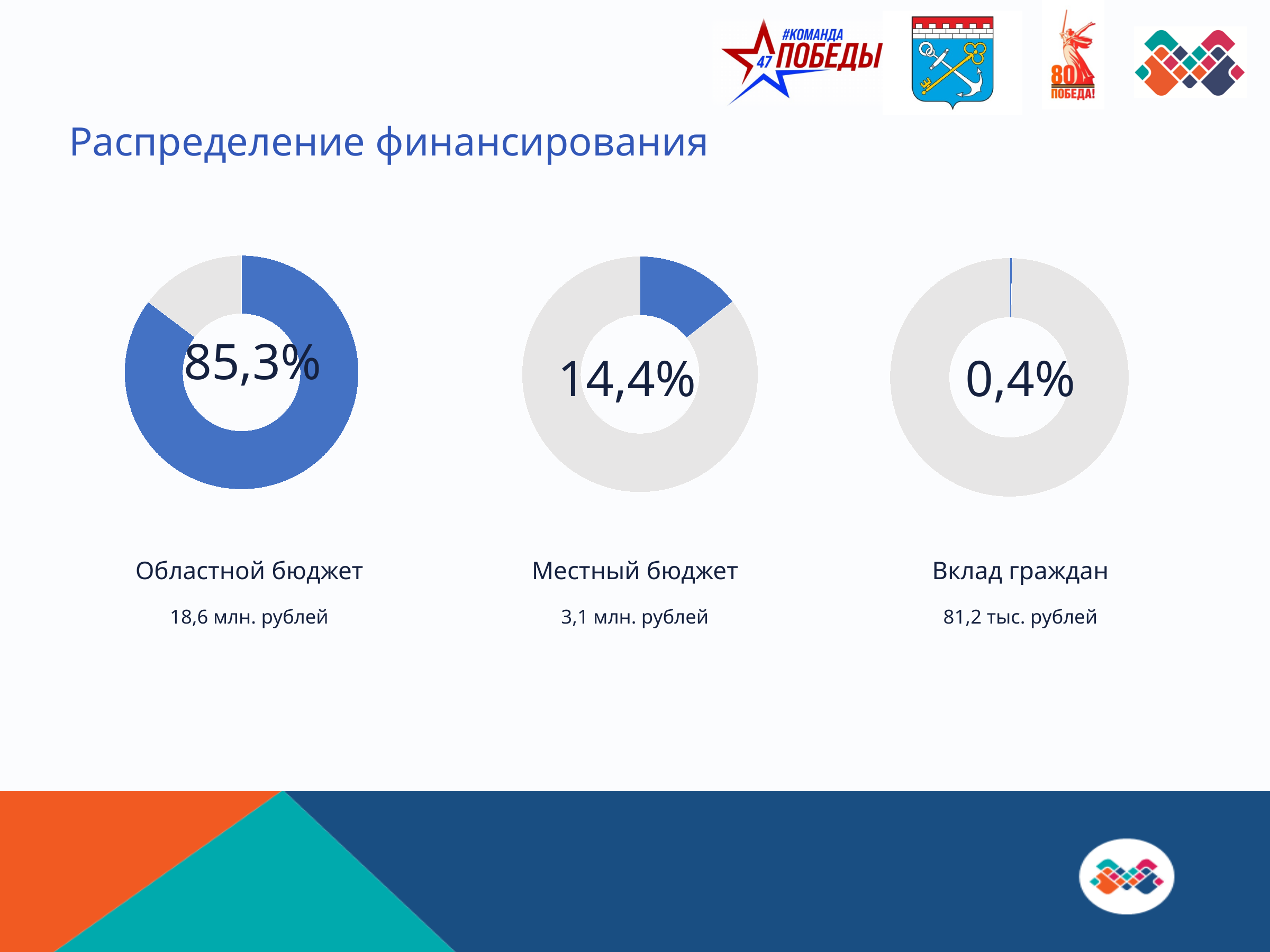
What amount in rubles is given under the Вклад граждан chart? 81,2 тыс. рублей What share is shown in the donut chart for Областной бюджет? 85,3% Which is larger, the share for Местный бюджет or the share for Вклад граждан? Местный бюджет Which of the three funding sources has the largest share? Областной бюджет What is the title of the slide containing the charts? Распределение финансирования Which of the three funding sources has the smallest share? Вклад граждан How many donut charts are shown on the slide? 3 What share is shown in the donut chart for Местный бюджет? 14,4% What amount in rubles is given under the Областной бюджет chart? 18,6 млн. рублей What amount in rubles is given under the Местный бюджет chart? 3,1 млн. рублей What is the difference in percentage points between the Областной бюджет share and the Местный бюджет share? 70,9 What share is shown in the donut chart for Вклад граждан? 0,4%